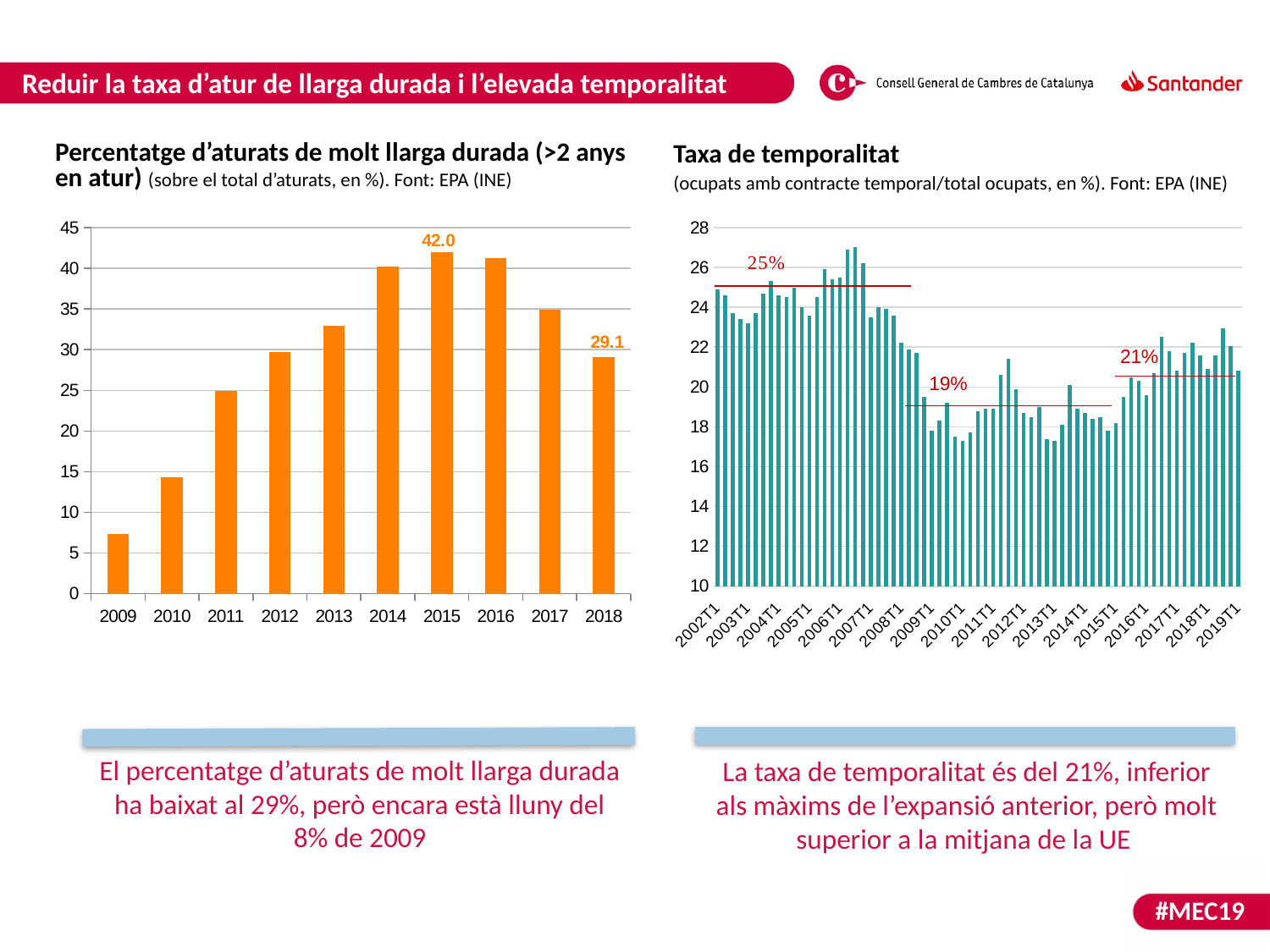
In the left chart (Percentatge d'aturats de molt llarga durada), which year has the highest value? 2015 What kind of chart is the right chart (Taxa de temporalitat)? Bar chart In the left chart (Percentatge d'aturats de molt llarga durada), what is the value for 2018? 29.1 What kind of chart is the left chart (Percentatge d'aturats de molt llarga durada)? Bar chart In the left chart (Percentatge d'aturats de molt llarga durada), what is the value for 2015? 42.0 In the right chart (Taxa de temporalitat), is the value for 2013T1 greater or less than 18? less How many years are shown on the x axis of the left chart (Percentatge d'aturats de molt llarga durada)? 10 In the left chart (Percentatge d'aturats de molt llarga durada), what is the difference between the 2015 value and the 2018 value? 12.9 In the left chart (Percentatge d'aturats de molt llarga durada), is the value for 2014 greater or less than 35? greater In the left chart (Percentatge d'aturats de molt llarga durada), which year has the lowest value? 2009 In the left chart (Percentatge d'aturats de molt llarga durada), is the value for 2009 greater or less than 10? less In the left chart (Percentatge d'aturats de molt llarga durada), which year has the larger value, 2011 or 2013? 2013